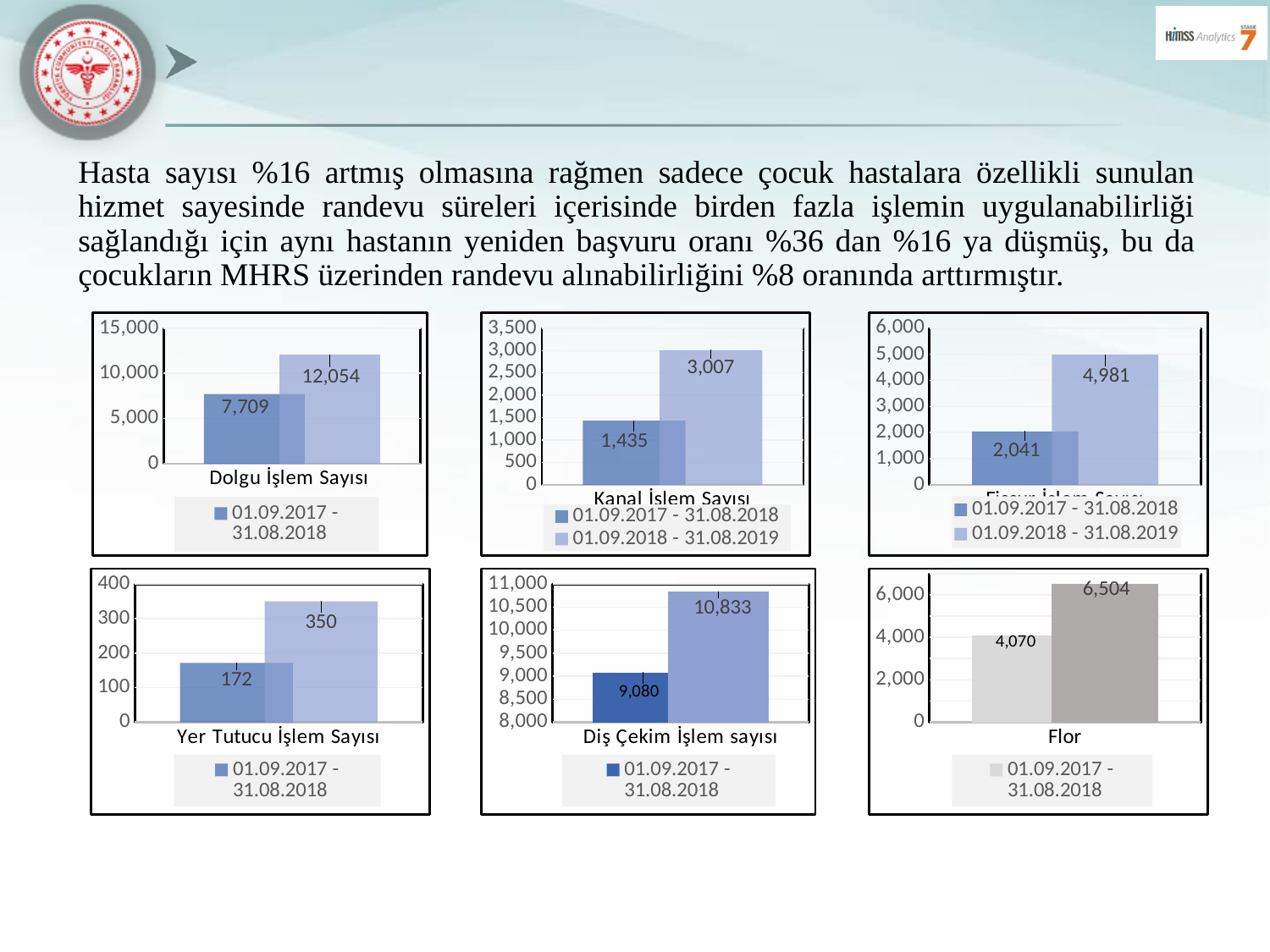
In the Dolgu İşlem Sayısı chart, what is the value of the darker bar labelled for 01.09.2017 - 31.08.2018? 7,709 In the Kanal İşlem Sayısı chart, what is the value for 01.09.2017 - 31.08.2018? 1,435 What kind of chart is the Flor chart? bar chart In the top-right chart, what is the difference between the 01.09.2018 - 31.08.2019 value and the 01.09.2017 - 31.08.2018 value? 2,940 In the top-right chart, what is the value for 01.09.2018 - 31.08.2019? 4,981 In the Dolgu İşlem Sayısı chart, what is the difference between the two bars? 4,345 In the Yer Tutucu İşlem Sayısı chart, which bar is higher, the one labelled 172 or the one labelled 350? 350 In the Flor chart, what is the total of the two bars? 10,574 How many series does the legend of the Kanal İşlem Sayısı chart list? 2 In the Dolgu İşlem Sayısı chart, what is the value of the taller, lighter bar? 12,054 In the Diş Çekim İşlem sayısı chart, what is the value of the taller bar? 10,833 In the Kanal İşlem Sayısı chart, what is the value for 01.09.2018 - 31.08.2019? 3,007